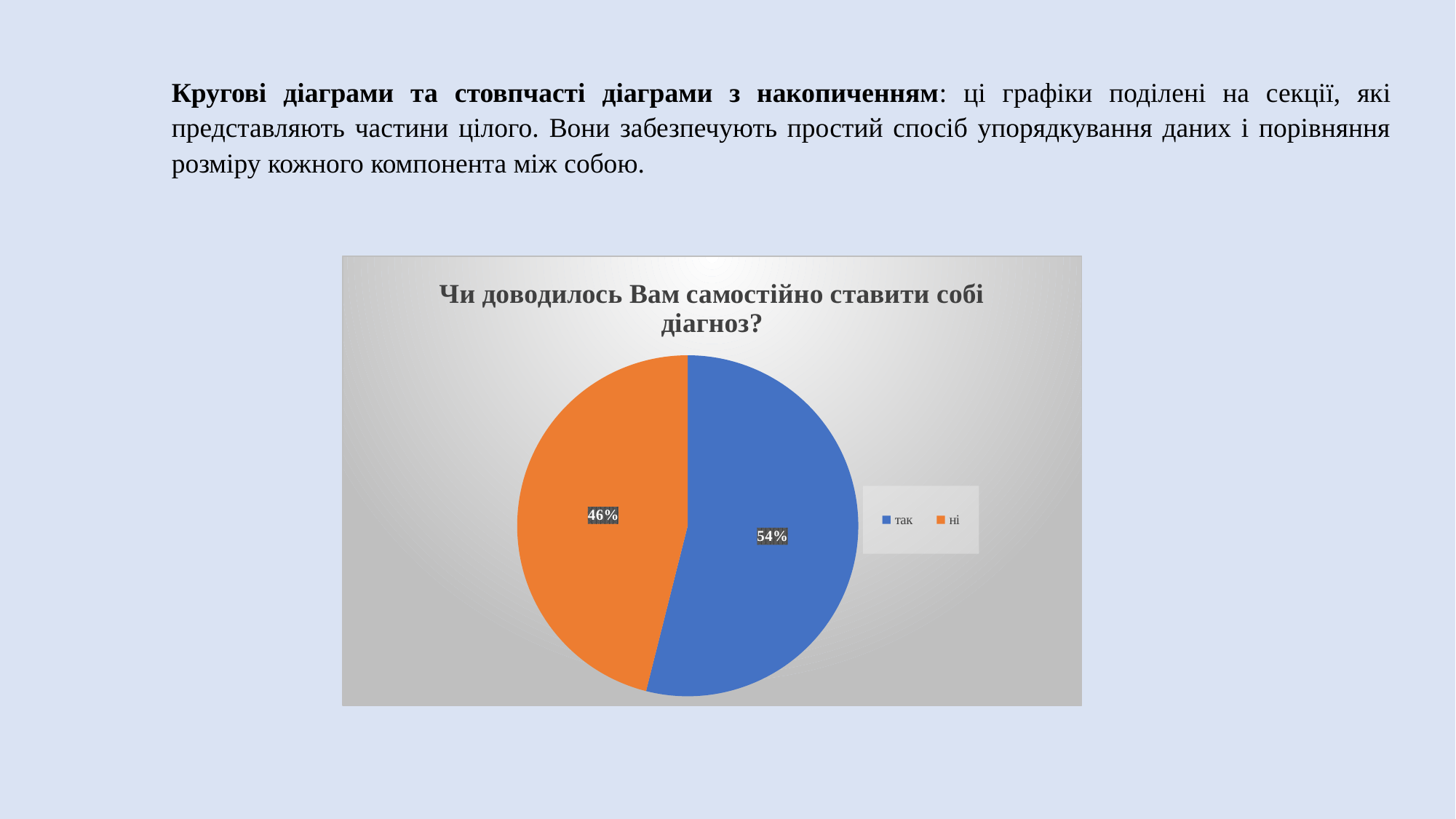
How many entries does the legend list? 2 What share of the pie is labelled "ні"? 46% What is the title of the chart? Чи доводилось Вам самостійно ставити собі діагноз? What kind of chart is shown on the slide? pie chart What share of the pie is labelled "так"? 54% Is the share for "так" greater or less than 50%? greater Which slice is the smallest? ні Which slice is the largest? так How many slices does the pie chart have? 2 By how many percentage points does "так" exceed "ні"? 8% Which is larger, the "так" slice or the "ні" slice? так What colour is the "ні" slice? orange